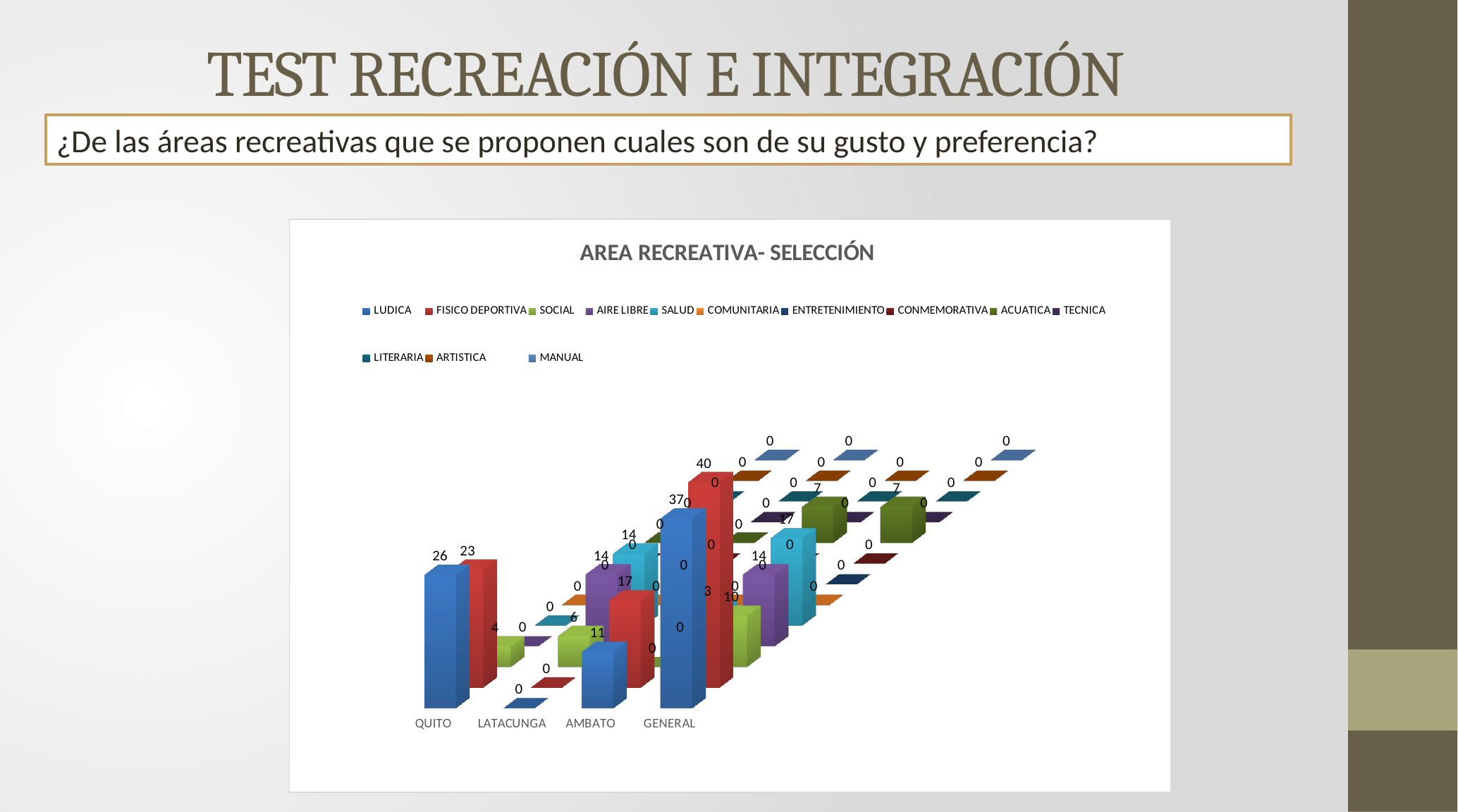
How many categories are shown on the x axis of the chart? 4 What is the FISICO DEPORTIVA value for GENERAL? 40 What is the LUDICA value for QUITO? 26 How many series does the chart legend list? 13 Which category has the highest LUDICA value? GENERAL What kind of chart is shown on the slide? Bar chart What is the FISICO DEPORTIVA value for QUITO? 23 What is the difference between the LUDICA and FISICO DEPORTIVA values for QUITO? 3 For GENERAL, which is larger: the LUDICA value or the FISICO DEPORTIVA value? FISICO DEPORTIVA What is the title of the chart? AREA RECREATIVA- SELECCIÓN What is the LUDICA value for GENERAL? 37 What is the LUDICA value for AMBATO? 11